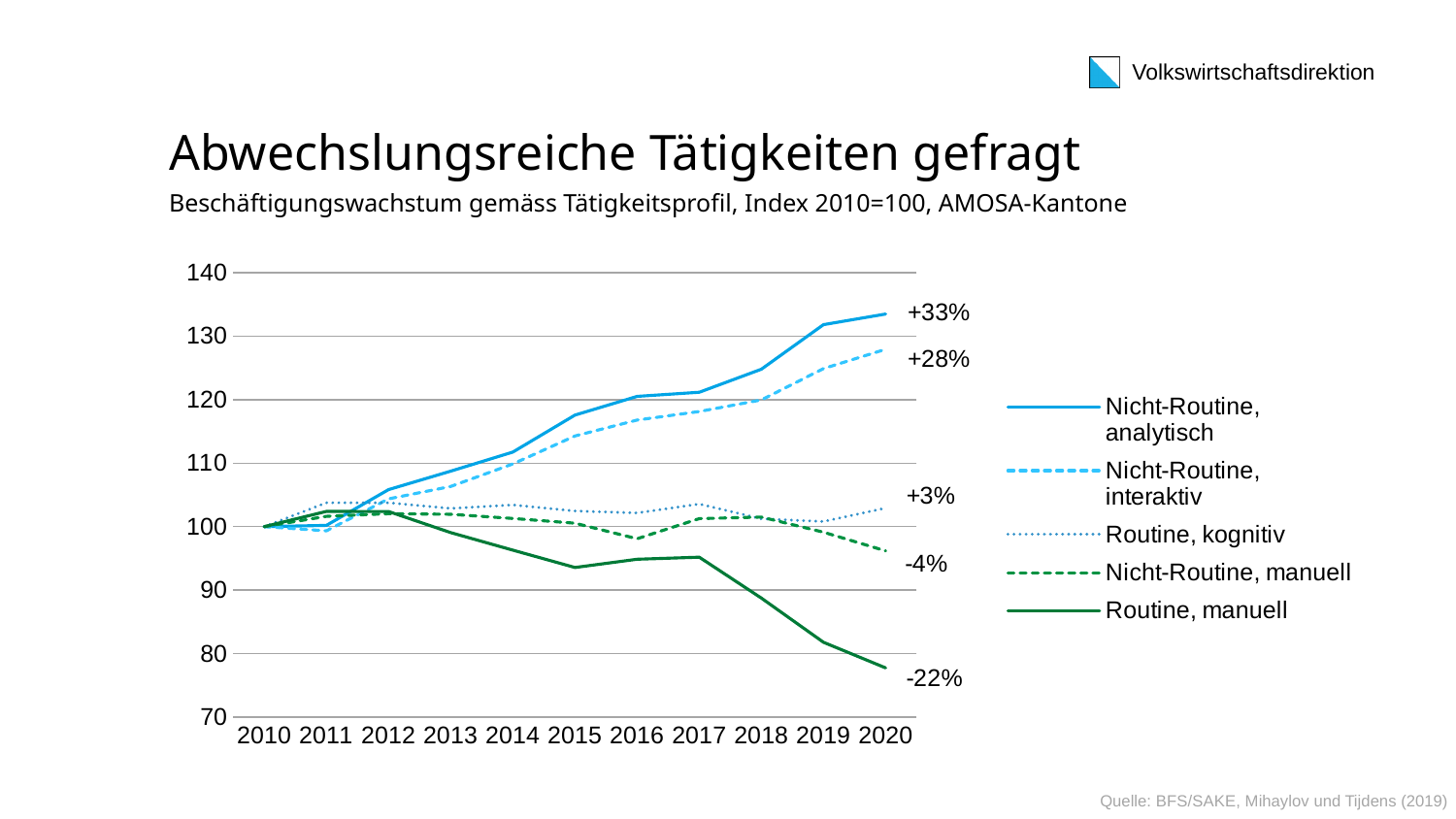
What percentage change is labelled at the end of the 'Nicht-Routine, interaktiv' line? +28% What percentage change is labelled at the end of the 'Nicht-Routine, analytisch' line? +33% What kind of chart is shown on the slide? line chart Which series has the lowest value in 2020? Routine, manuell How many years are shown on the x axis? 11 Does the 'Routine, manuell' line rise or fall from 2010 to 2020? fall What percentage change is labelled at the end of the 'Routine, manuell' line? -22% How many series does the legend list? 5 Is the value for 'Routine, manuell' in 2020 greater or less than 90? less Which series has the highest value in 2020? Nicht-Routine, analytisch Is the value for 'Nicht-Routine, analytisch' in 2020 greater or less than 130? greater What is the difference between the percentage labels for 'Nicht-Routine, analytisch' and 'Nicht-Routine, interaktiv'? 5 percentage points